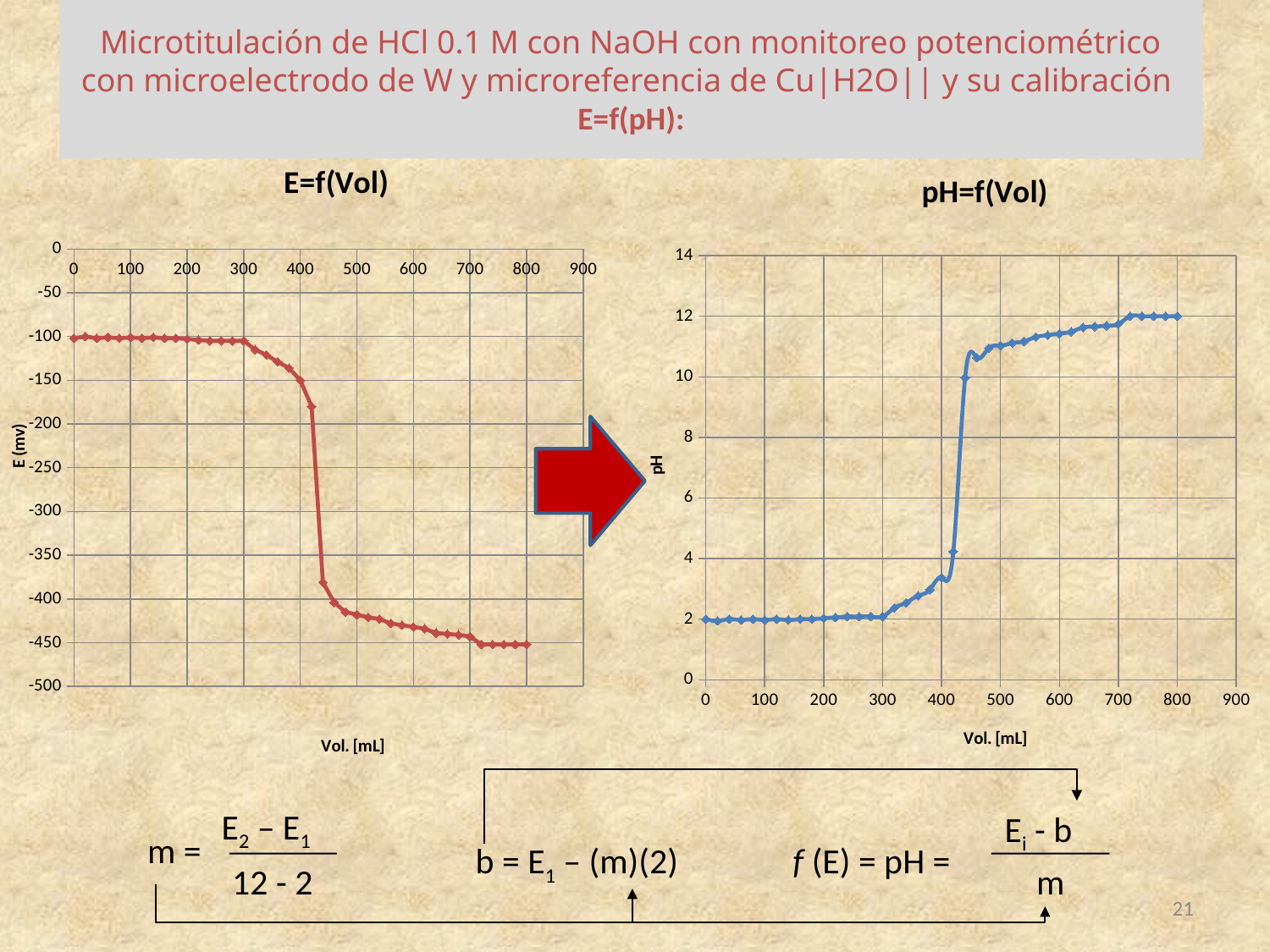
What is the y-axis label of the E=f(Vol) chart? E (mv) What kind of chart is the pH=f(Vol) chart on the right? line chart In the E=f(Vol) chart, is the value of E at a volume of 800 mL greater or less than -400? less In the E=f(Vol) chart, is the value of E at a volume of 100 mL greater or less than -50? less In the E=f(Vol) chart, do the values rise or fall as volume increases along the x axis? fall What is the x-axis label of the pH=f(Vol) chart? Vol. [mL] In the pH=f(Vol) chart, which is larger: the pH at 100 mL or at 800 mL? 800 mL In the E=f(Vol) chart, which is larger: the value of E at 100 mL or at 800 mL? 100 mL In the pH=f(Vol) chart, do the values rise or fall as volume increases along the x axis? rise What kind of chart is the E=f(Vol) chart on the left? line chart In the pH=f(Vol) chart, is the pH at a volume of 100 mL greater or less than 4? less